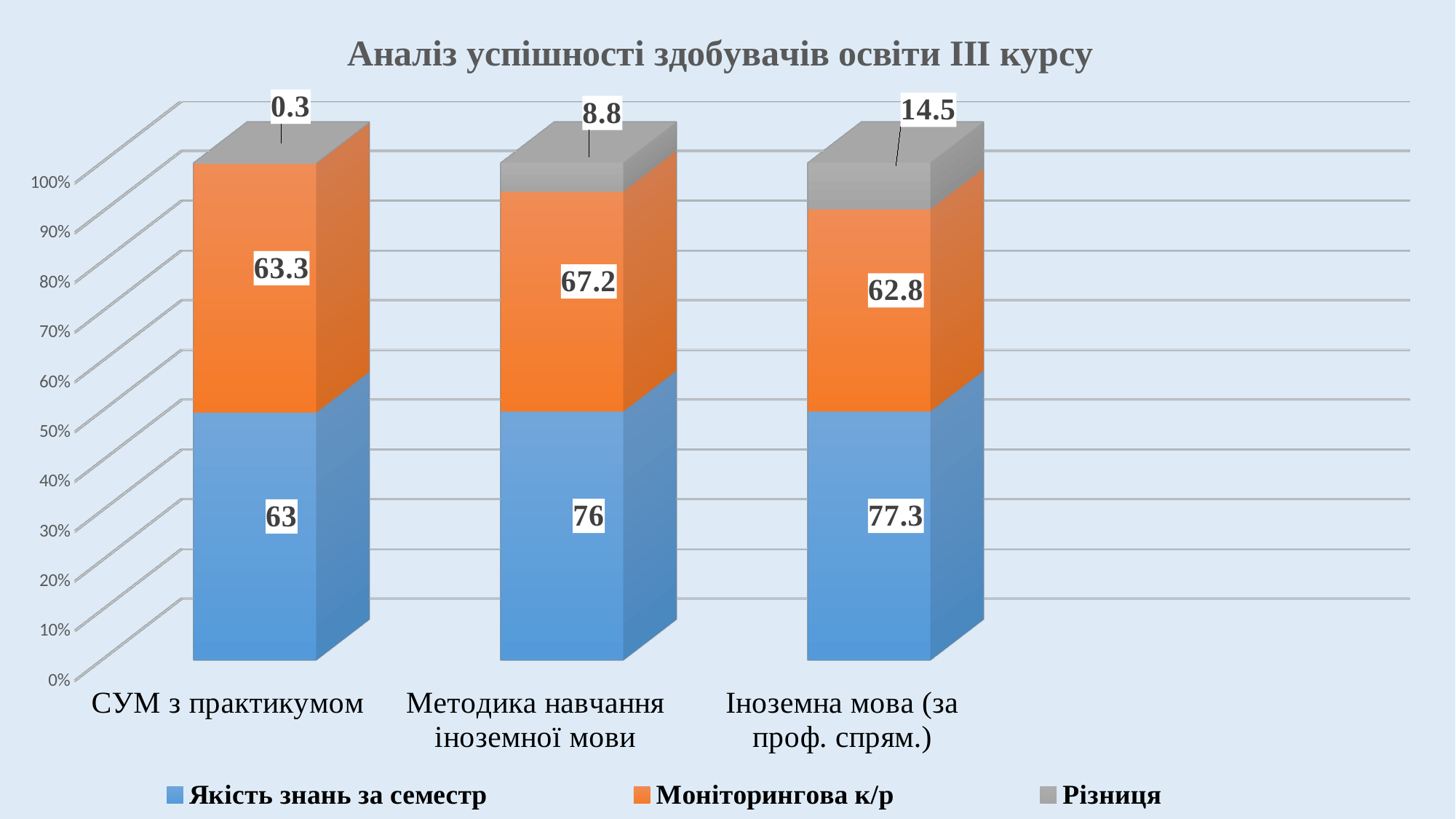
Which category has the highest value for "Різниця"? Іноземна мова (за проф. спрям.) Which is larger: the "Моніторингова к/р" value for "СУМ з практикумом" or for "Іноземна мова (за проф. спрям.)"? СУМ з практикумом What kind of chart is shown on the slide? Stacked bar chart What is the value of "Якість знань за семестр" for "Іноземна мова (за проф. спрям.)"? 77.3 What is the title of the chart? Аналіз успішності здобувачів освіти ІІІ курсу What is the value of "Різниця" for "Іноземна мова (за проф. спрям.)"? 14.5 What is the difference between the "Якість знань за семестр" values for "Методика навчання іноземної мови" and "СУМ з практикумом"? 13 What is the value of "Моніторингова к/р" for "Методика навчання іноземної мови"? 67.2 What is the value of "Якість знань за семестр" for "СУМ з практикумом"? 63 How many categories are shown on the x axis? 3 Which category has the lowest value for "Якість знань за семестр"? СУМ з практикумом How many series does the legend list? 3